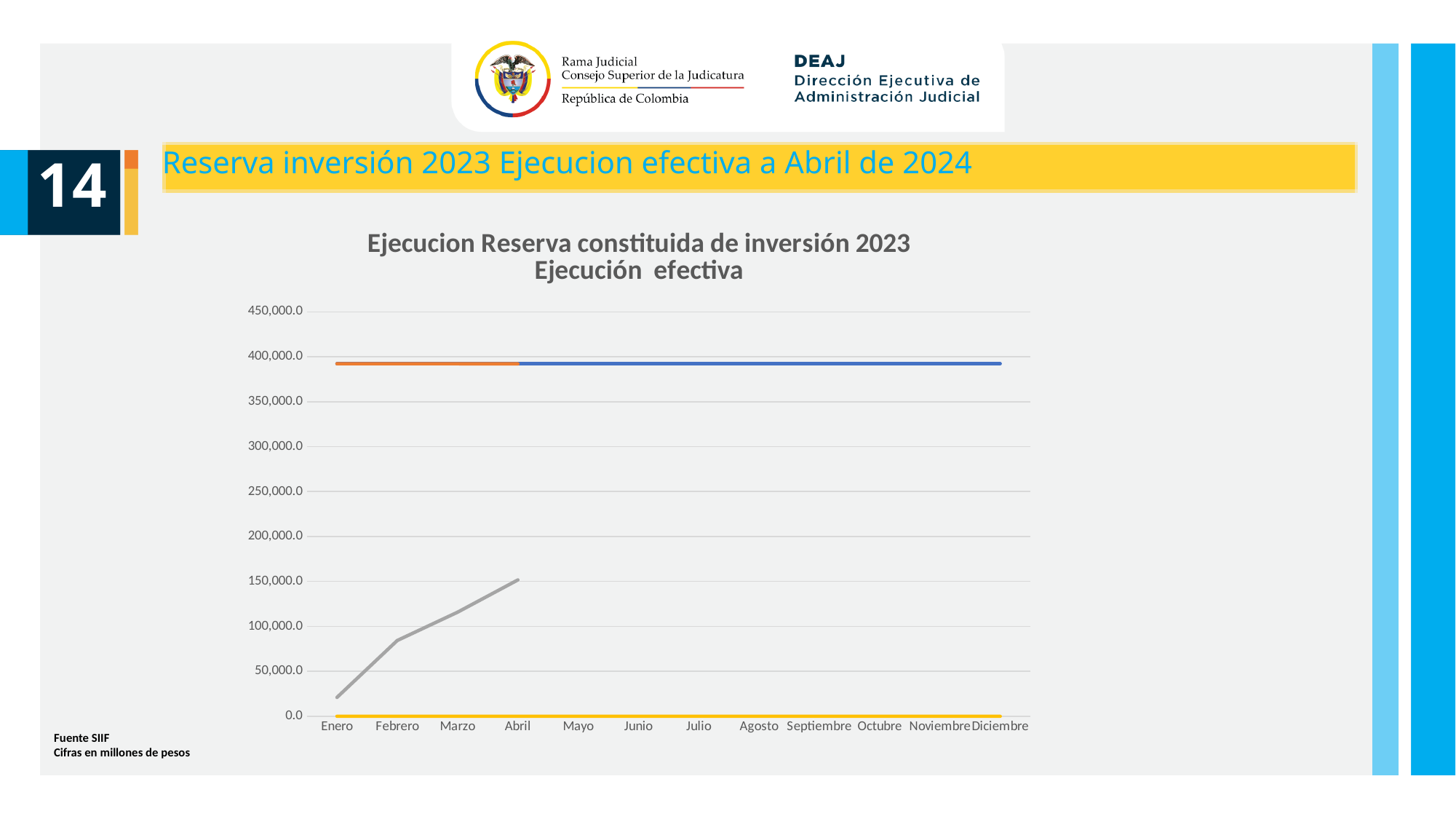
Which month is the last one shown on the x axis? Diciembre What kind of chart is shown on the slide? line chart Does the gray line rise or fall from Enero to Abril? rise Is the value of the gray line in Abril greater or less than 100,000.0? greater Is the value of the gray line in Enero greater or less than 50,000.0? less In Abril, which is higher: the gray line or the orange line? the orange line Is the value of the gray line in Febrero greater or less than 100,000.0? less How many months are listed along the x axis of the chart? 12 What is the title of the chart? Ejecucion Reserva constituida de inversión 2023 Ejecución efectiva